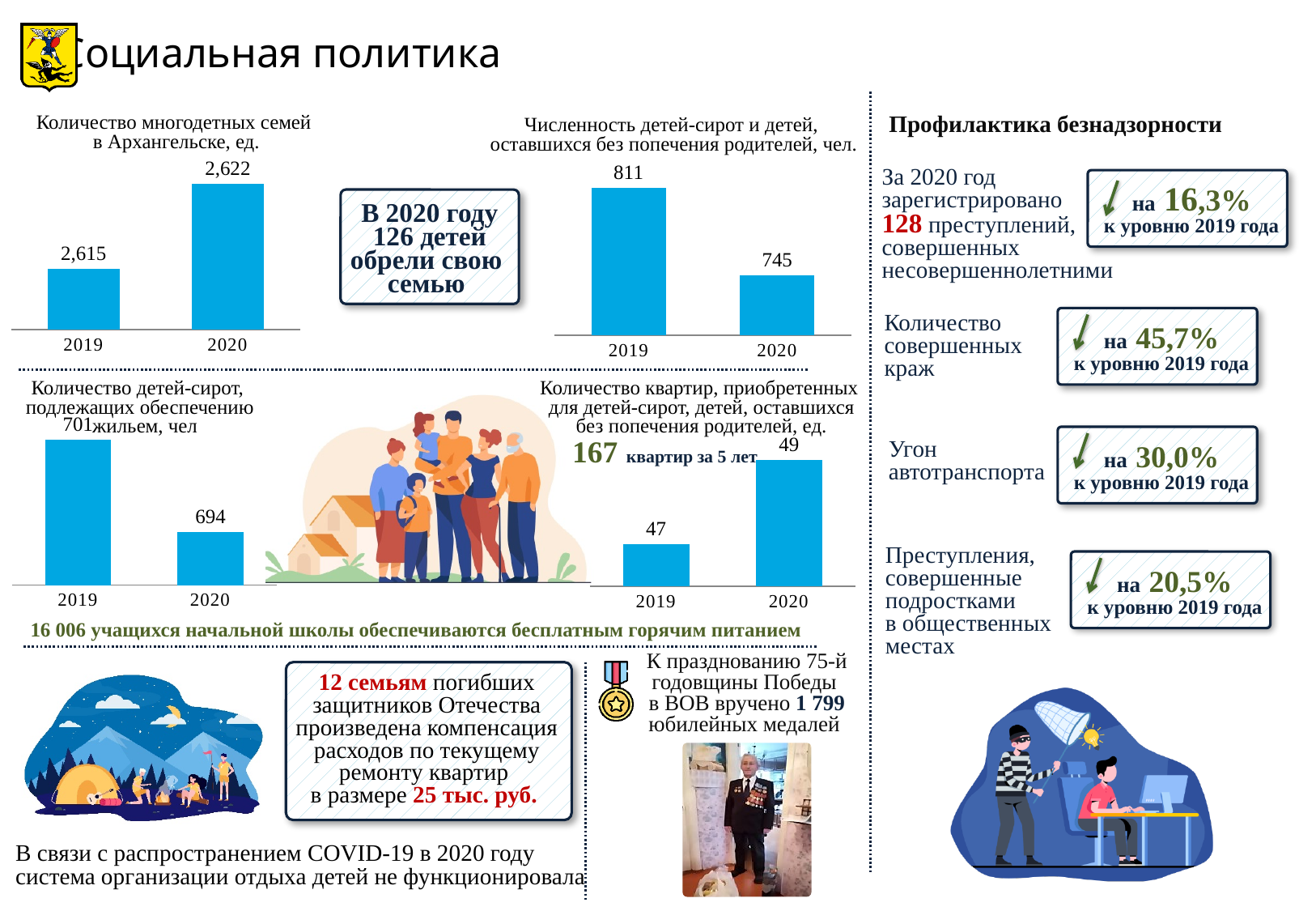
In the chart 'Численность детей-сирот и детей, оставшихся без попечения родителей, чел.', what is the difference between the 2019 and 2020 values? 66 In the chart 'Численность детей-сирот и детей, оставшихся без попечения родителей, чел.', what is the value for 2019? 811 What type of chart is 'Численность детей-сирот и детей, оставшихся без попечения родителей, чел.'? bar chart In the chart 'Численность детей-сирот и детей, оставшихся без попечения родителей, чел.', do the values rise or fall from 2019 to 2020? fall In the chart 'Количество квартир, приобретенных для детей-сирот, детей, оставшихся без попечения родителей, ед.', what is the value for 2020? 49 In the chart 'Количество квартир, приобретенных для детей-сирот, детей, оставшихся без попечения родителей, ед.', which year has the lower value? 2019 In the chart 'Количество многодетных семей в Архангельске, ед.', what is the value for 2020? 2,622 In the chart 'Количество детей-сирот, подлежащих обеспечению жильем, чел', which year has the higher value? 2019 How many categories are shown on the x axis of the chart 'Количество многодетных семей в Архангельске, ед.'? 2 In the chart 'Количество детей-сирот, подлежащих обеспечению жильем, чел', what is the value for 2020? 694 In the chart 'Количество детей-сирот, подлежащих обеспечению жильем, чел', what is the difference between the 2019 and 2020 values? 7 In the chart 'Количество многодетных семей в Архангельске, ед.', what is the value for 2019? 2,615